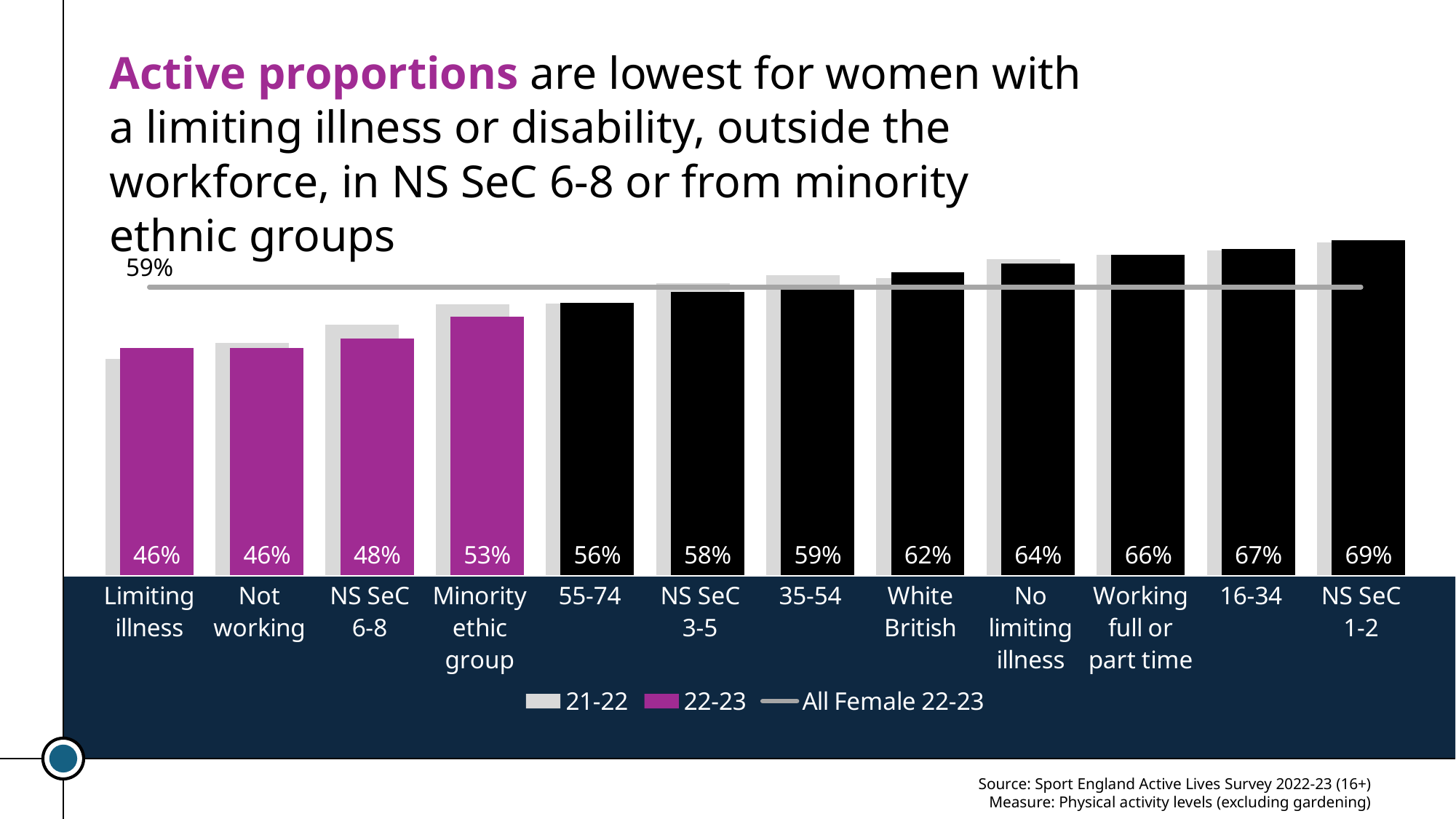
How many entries does the legend list? 3 What is the value of the All Female 22-23 line? 59% What is the difference between the 22-23 active proportions for NS SeC 1-2 and NS SeC 6-8? 21% What is the 22-23 active proportion for women with a limiting illness? 46% Which colour are the bars for the four lowest 22-23 categories? Purple What is the 22-23 active proportion for women from a minority ethnic group? 53% What is the 22-23 active proportion for women in NS SeC 1-2? 69% Which category has the highest 22-23 active proportion? NS SeC 1-2 How many categories are shown on the x axis? 12 What kind of chart is shown on the slide? Combination bar and line chart Do the 22-23 values rise or fall from left to right along the x axis? Rise Which has a higher 22-23 active proportion: White British or 35-54? White British